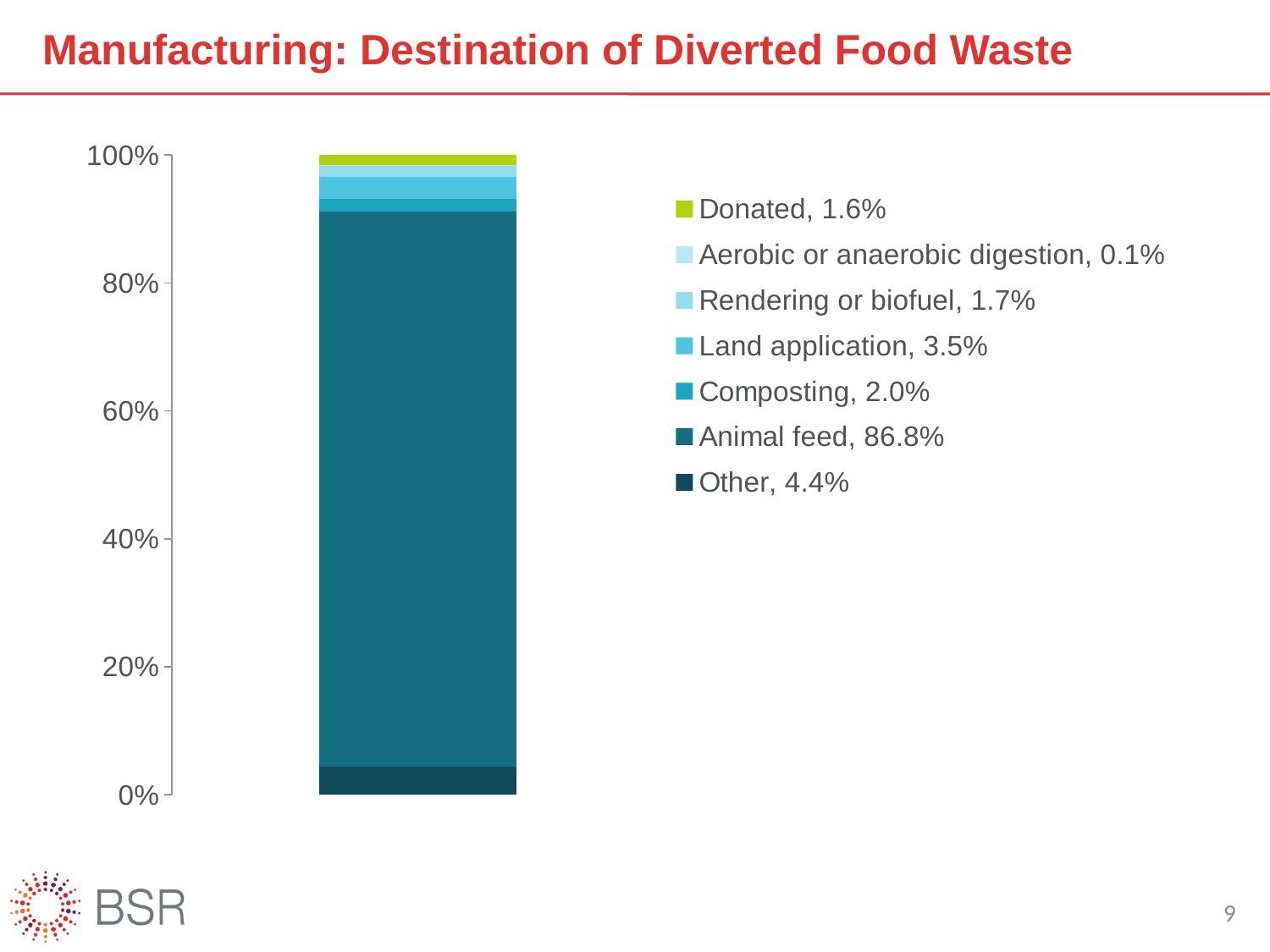
Which destination has the smallest share of diverted food waste? Aerobic or anaerobic digestion What is the title of the chart? Manufacturing: Destination of Diverted Food Waste How many series does the legend list? 7 What share of diverted food waste goes to animal feed? 86.8% What kind of chart is shown on the slide? Stacked bar chart What is the value for Aerobic or anaerobic digestion? 0.1% What is the difference between the Land application share and the Composting share? 1.5 percentage points How many percentage points larger is the Animal feed share than the Other share? 82.4 percentage points What is the value for Other? 4.4% Which is larger, the share for Rendering or biofuel or the share for Donated? Rendering or biofuel What is the value for Land application? 3.5% Which destination has the largest share of diverted food waste? Animal feed